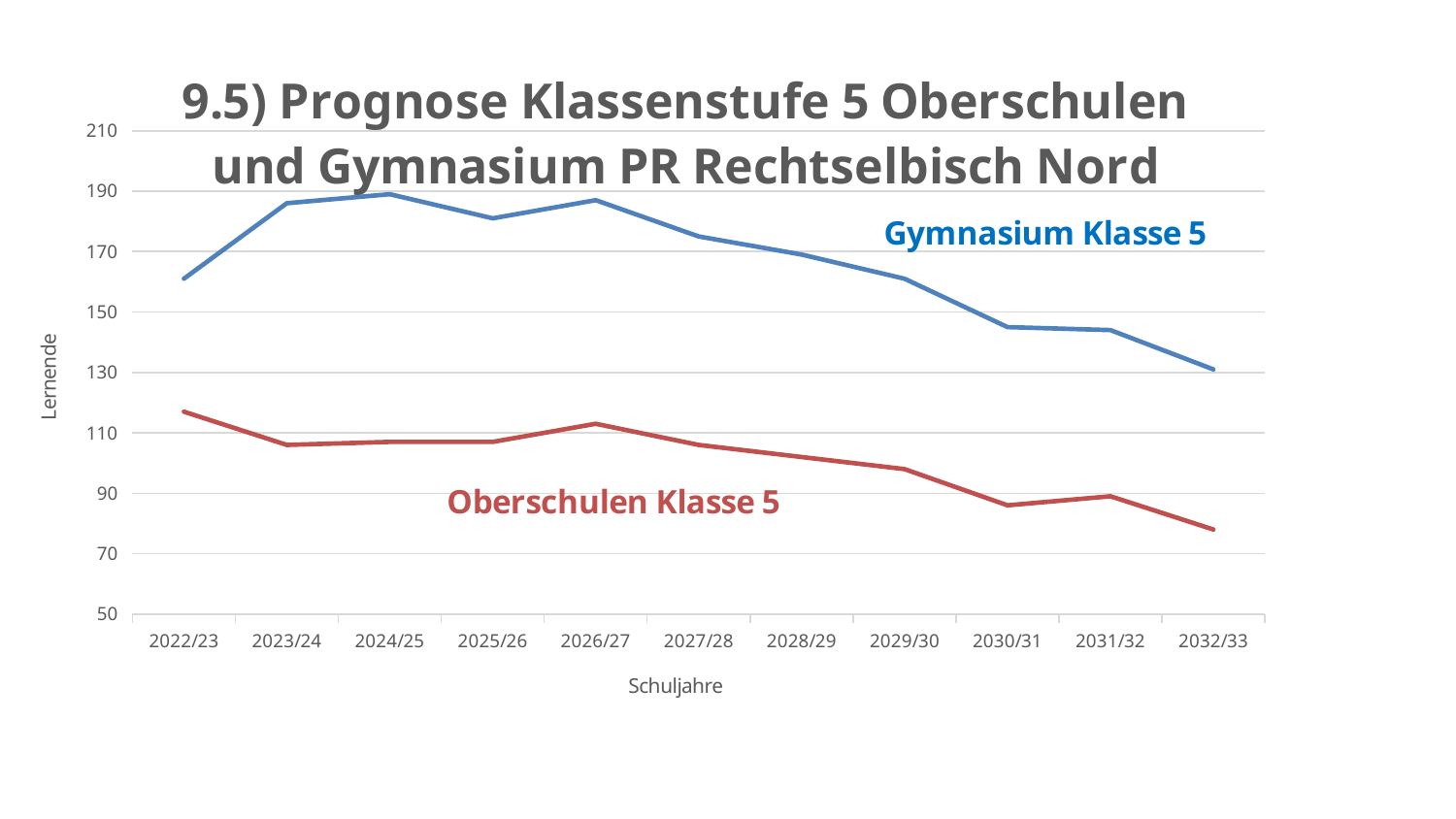
Does the Gymnasium Klasse 5 line rise or fall overall from 2026/27 to 2032/33? fall In which school year does Gymnasium Klasse 5 reach its lowest value? 2032/33 Is the value for Gymnasium Klasse 5 in 2024/25 greater or less than 170? greater How many series are plotted on the chart? 2 Is the value for Oberschulen Klasse 5 in 2022/23 greater or less than 110? greater What is the label on the y axis of the chart? Lernende In which school year does Oberschulen Klasse 5 reach its lowest value? 2032/33 Is the value for Gymnasium Klasse 5 in 2032/33 greater or less than 150? less What kind of chart is shown on the slide? line chart Which series has the lower values across all years, Gymnasium Klasse 5 or Oberschulen Klasse 5? Oberschulen Klasse 5 How many school years are shown on the x axis? 11